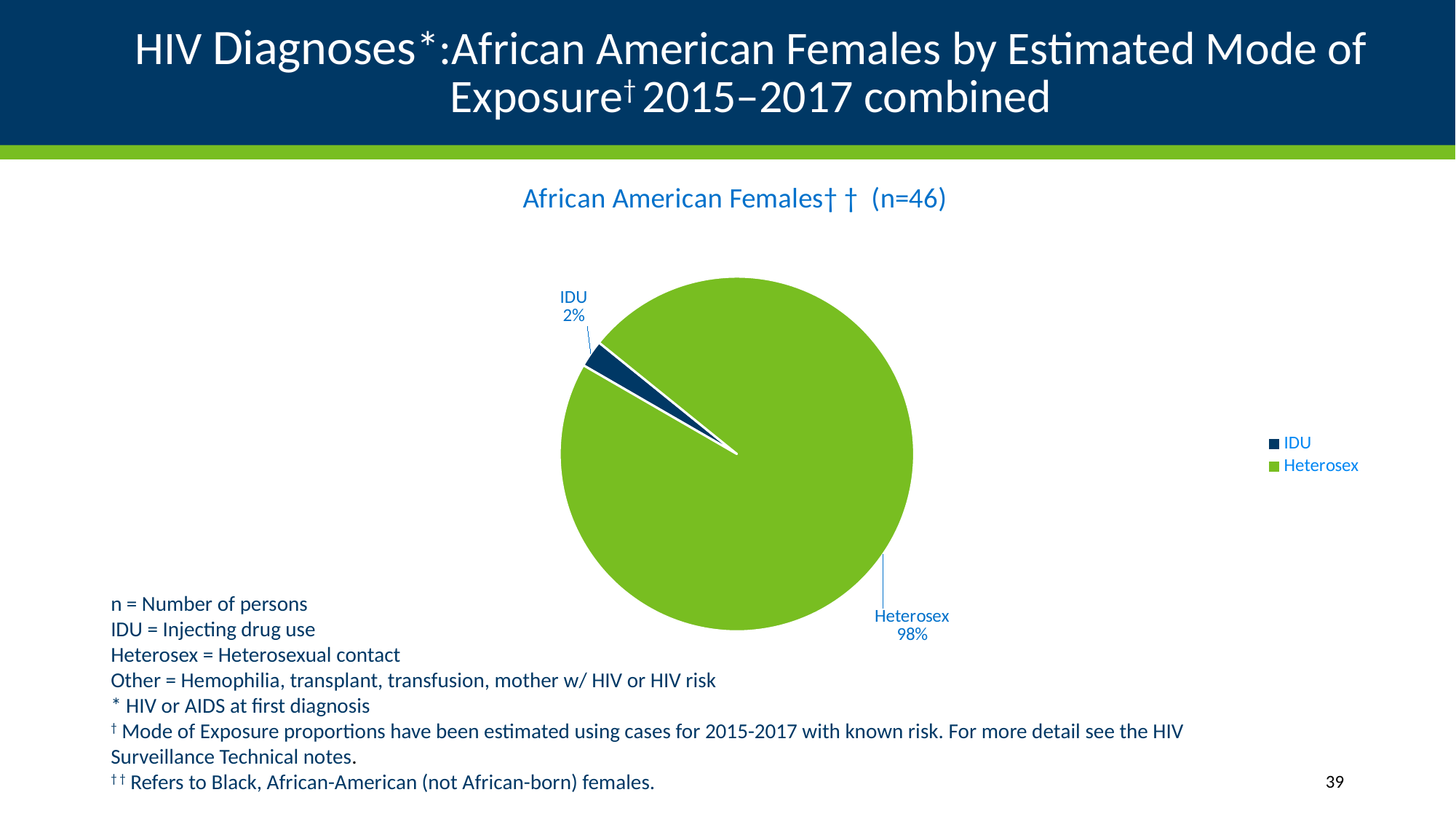
What share of the pie does IDU account for? 2% What colour is the Heterosex slice in the pie chart? Green Which mode of exposure has the largest slice of the pie? Heterosex Which is larger, the IDU slice or the Heterosex slice? Heterosex How many entries does the legend list? 2 Which mode of exposure has the smallest slice of the pie? IDU How many slices does the pie chart have? 2 What share of the pie does Heterosex account for? 98% What type of chart is shown on the slide? Pie chart What is the difference in percentage points between the Heterosex and IDU slices? 96 What is the n value shown in the chart title? n=46